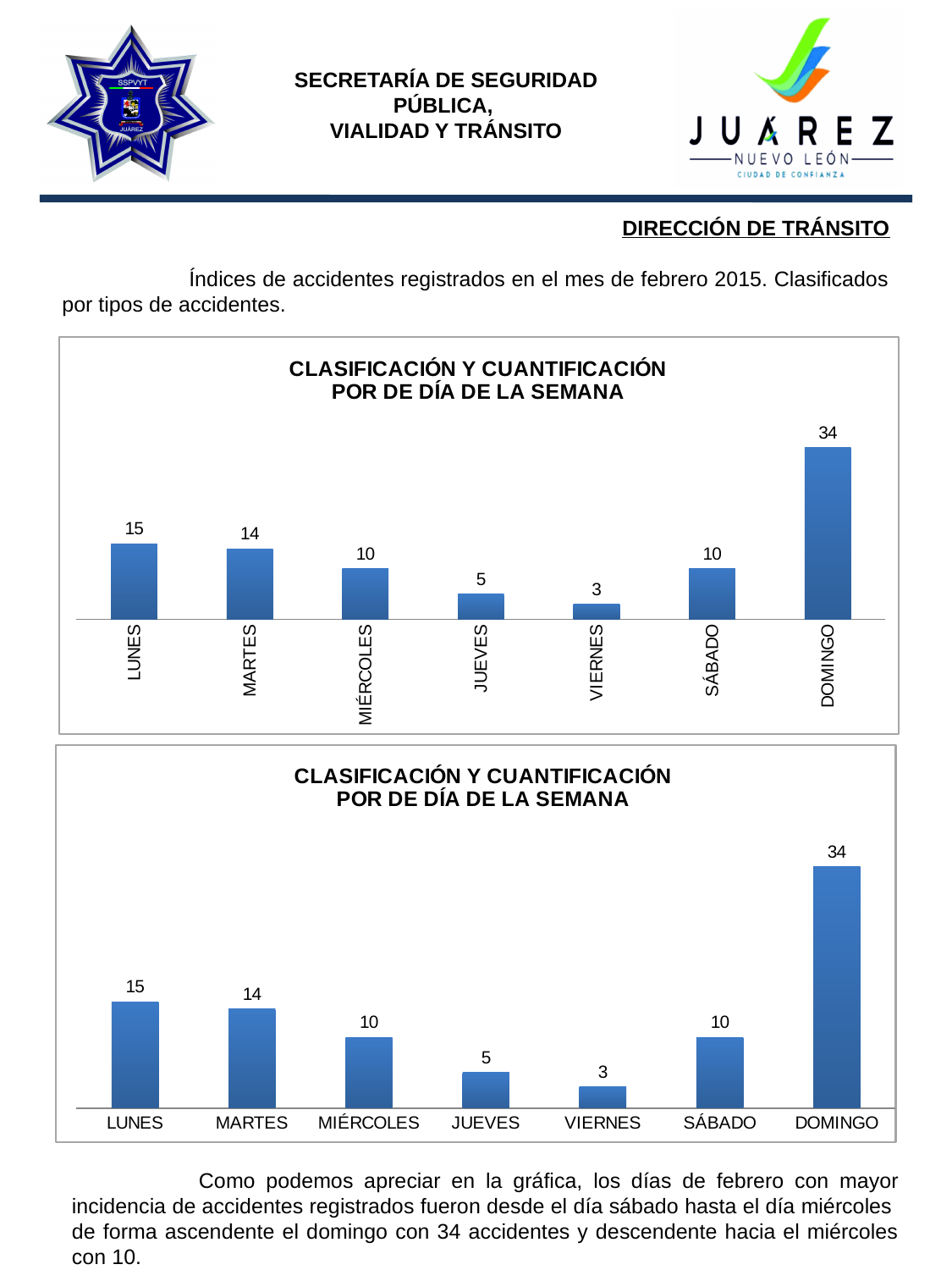
In the top chart, do the values rise or fall from LUNES to VIERNES? Fall In the top chart, what is the value for MARTES? 14 In the bottom chart, what is the value for VIERNES? 3 In the top chart, which day has the lowest value? VIERNES In the bottom chart, which is larger, the value for LUNES or the value for SÁBADO? LUNES In the top chart, what is the difference between the values for JUEVES and VIERNES? 2 In the bottom chart, which day has the highest value? DOMINGO How many days (categories) are shown in the top chart? 7 What kind of chart is the bottom chart? Bar chart In the top chart, what is the value for DOMINGO? 34 What is the title of the bottom chart? CLASIFICACIÓN Y CUANTIFICACIÓN POR DE DÍA DE LA SEMANA In the bottom chart, what is the difference between the values for DOMINGO and LUNES? 19